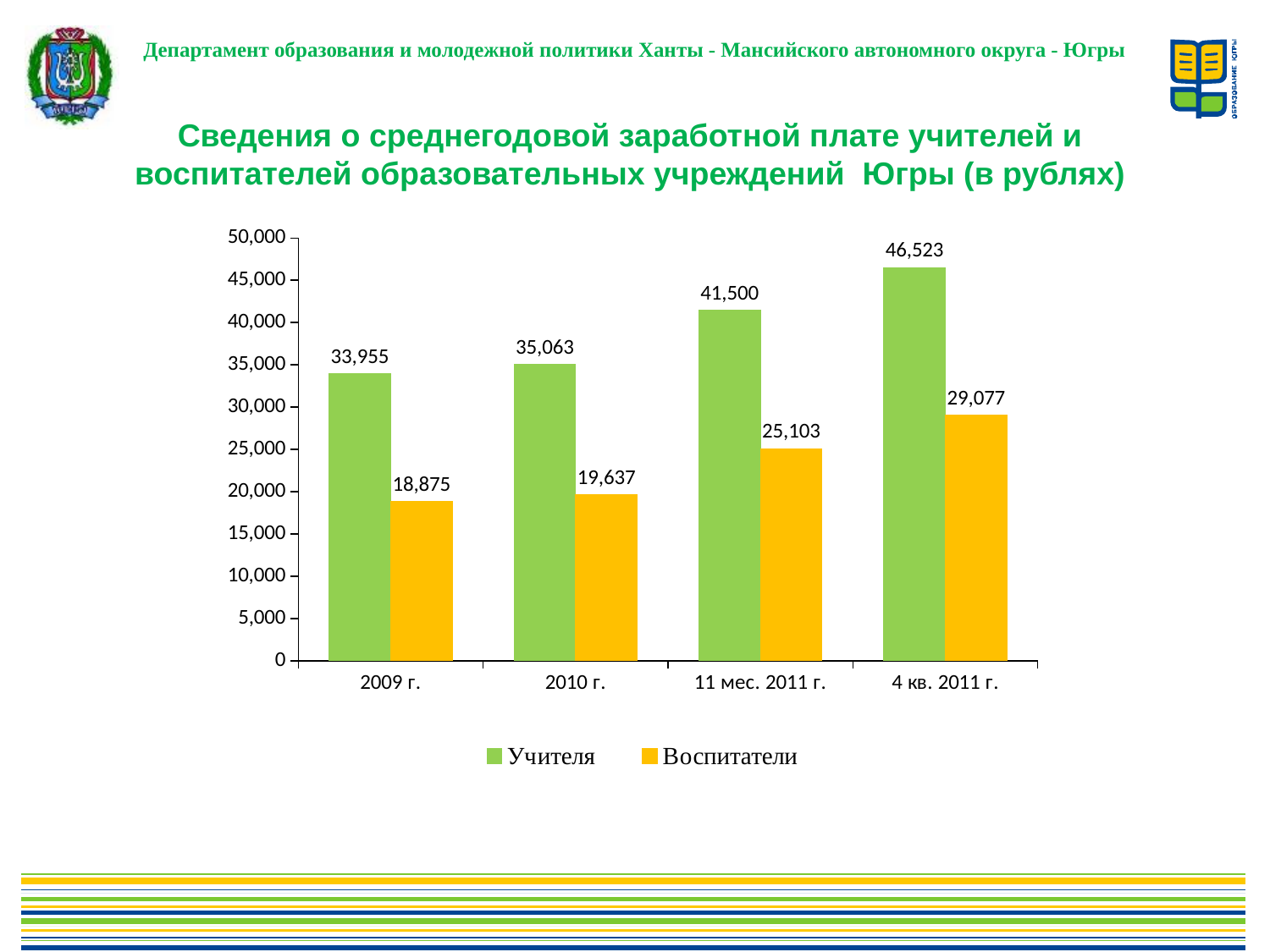
In which category is the value for Воспитатели lowest? 2009 г. What is the value for Учителя in 2010 г.? 35,063 What is the difference between the Учителя and Воспитатели values in 4 кв. 2011 г.? 17,446 How many series does the legend list? 2 Do the values for Воспитатели rise or fall from 2009 г. to 4 кв. 2011 г.? Rise What kind of chart is shown on the slide? Bar chart In which category is the value for Учителя highest? 4 кв. 2011 г. Which is larger: the Учителя value in 2009 г. or the Воспитатели value in 4 кв. 2011 г.? Учителя value in 2009 г. How many categories are shown on the x axis? 4 What is the value for Учителя in 2009 г.? 33,955 What is the value for Воспитатели in 11 мес. 2011 г.? 25,103 What is the value for Воспитатели in 4 кв. 2011 г.? 29,077